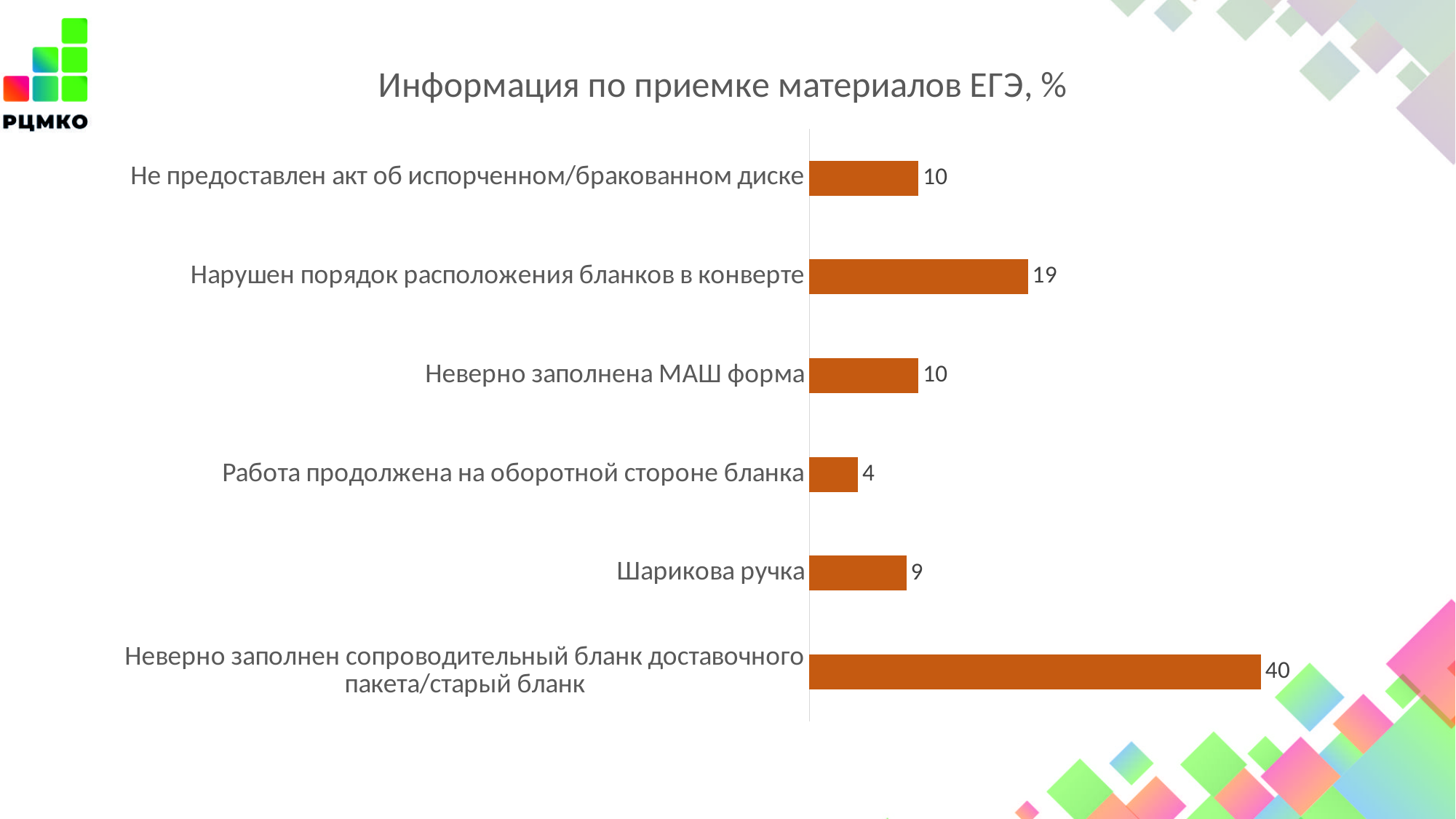
What is the value for "Шарикова ручка"? 9 Which is larger: the value for "Шарикова ручка" or the value for "Неверно заполнена МАШ форма"? Неверно заполнена МАШ форма What is the value for "Нарушен порядок расположения бланков в конверте"? 19 What is the difference between the values for "Неверно заполнен сопроводительный бланк доставочного пакета/старый бланк" and "Нарушен порядок расположения бланков в конверте"? 21 Which category has the highest value? Неверно заполнен сопроводительный бланк доставочного пакета/старый бланк How many categories are shown in the chart? 6 What is the value for "Работа продолжена на оборотной стороне бланка"? 4 What is the difference between the values for "Не предоставлен акт об испорченном/бракованном диске" and "Работа продолжена на оборотной стороне бланка"? 6 Which category has the lowest value? Работа продолжена на оборотной стороне бланка What is the value for "Неверно заполнен сопроводительный бланк доставочного пакета/старый бланк"? 40 What kind of chart is shown on the slide? Bar chart What is the title of the chart? Информация по приемке материалов ЕГЭ, %